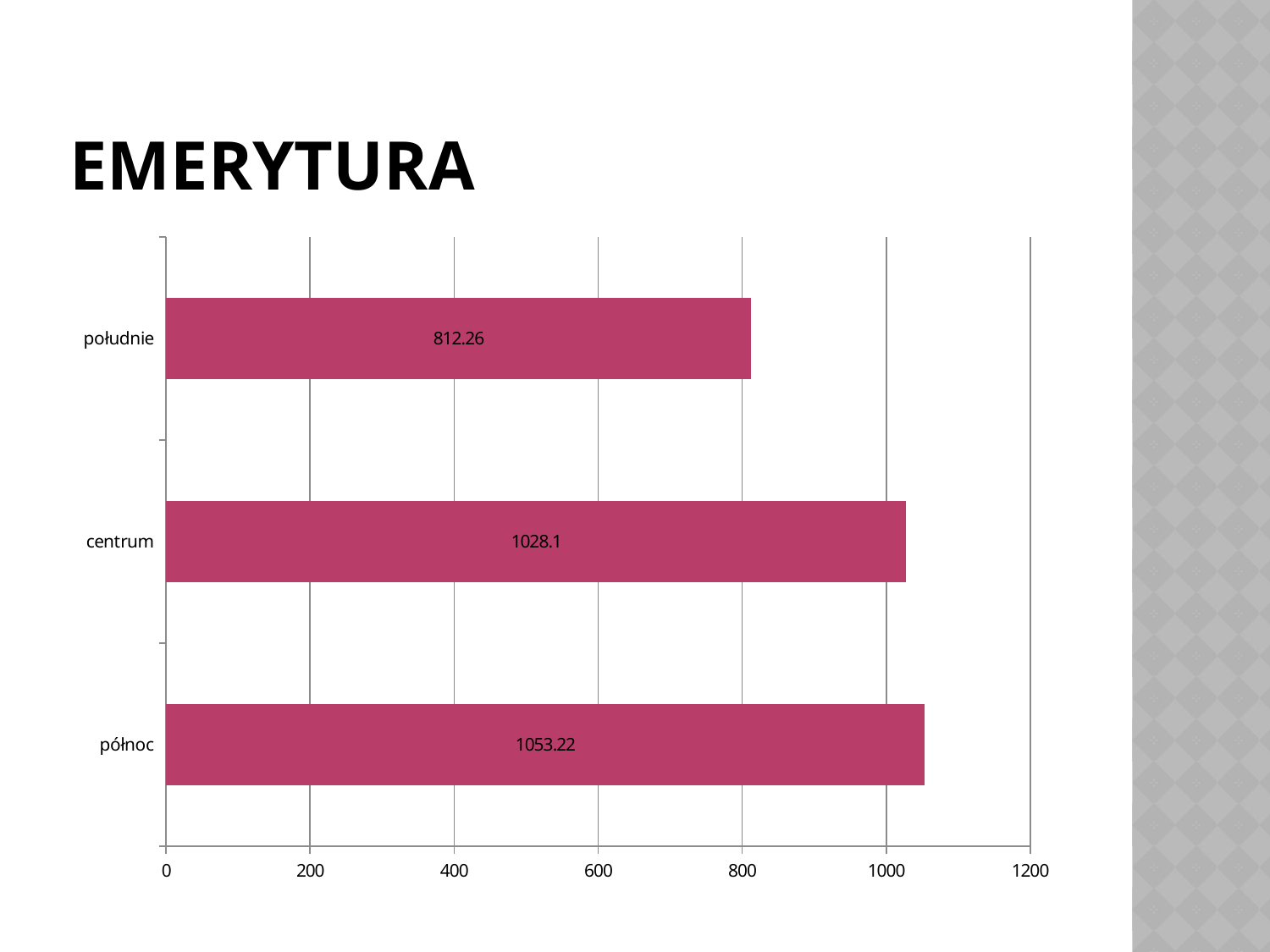
What is the difference between the values for centrum and południe? 215.84 How many categories are shown in the chart? 3 Which category has the highest value? północ What is the value for południe? 812.26 Which category has the lowest value? południe What is the title of the slide? EMERYTURA Which is larger, the value for centrum or the value for południe? centrum What is the difference between the values for północ and południe? 240.96 What kind of chart is shown on the slide? bar chart Is the value for południe greater or less than 1000? less What is the value for północ? 1053.22 What is the value for centrum? 1028.1